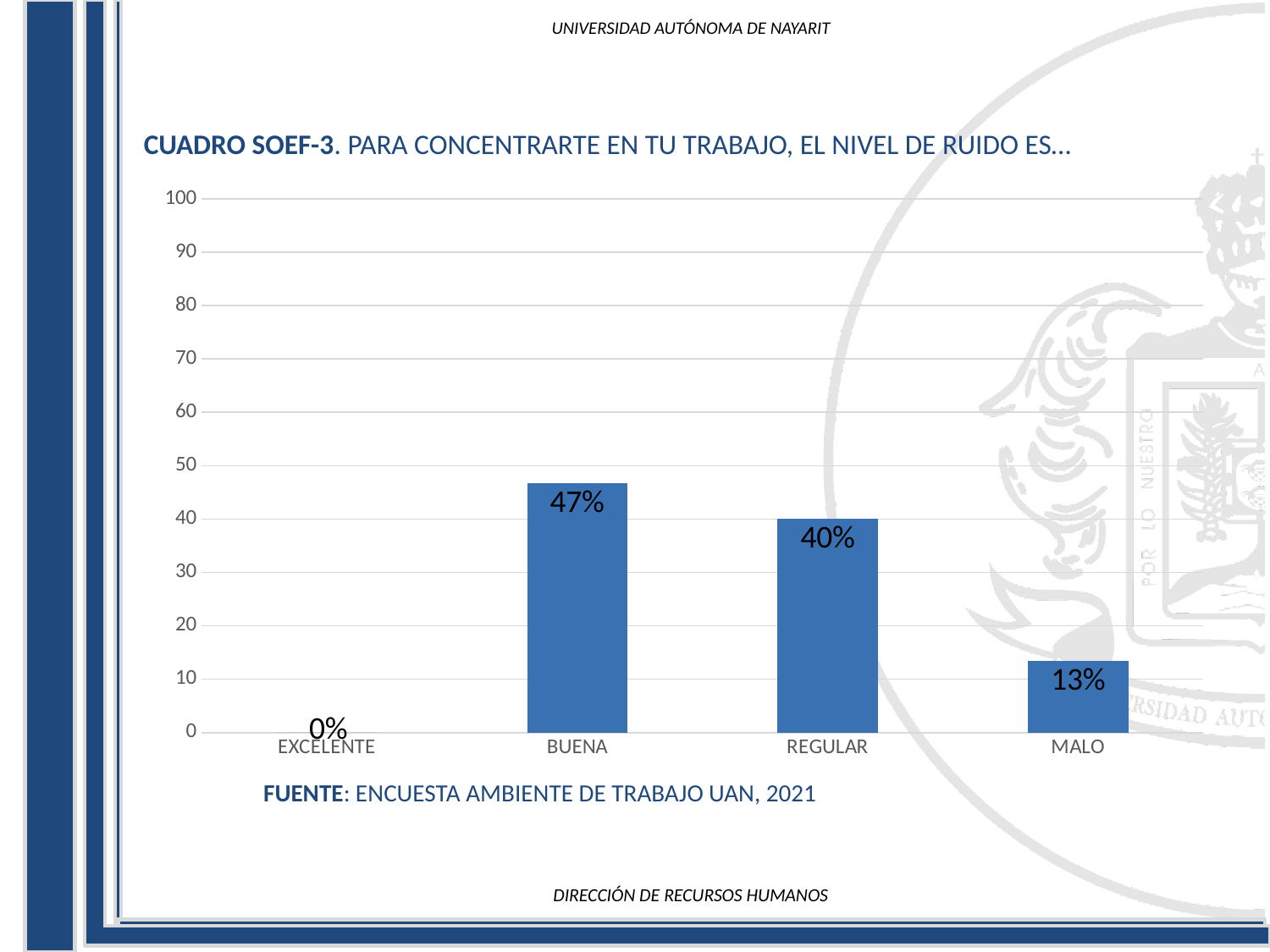
Which category has the highest value? BUENA What is the value for MALO? 13% What is the value for EXCELENTE? 0% What is the value for BUENA? 47% What is the value for REGULAR? 40% What is the difference between the values for BUENA and REGULAR? 7% Which is larger, the value for REGULAR or the value for MALO? REGULAR Which category has the lowest value? EXCELENTE What kind of chart is shown on the slide? Bar chart What is the difference between the values for REGULAR and MALO? 27% What source is cited below the chart? ENCUESTA AMBIENTE DE TRABAJO UAN, 2021 How many categories are shown on the x axis? 4